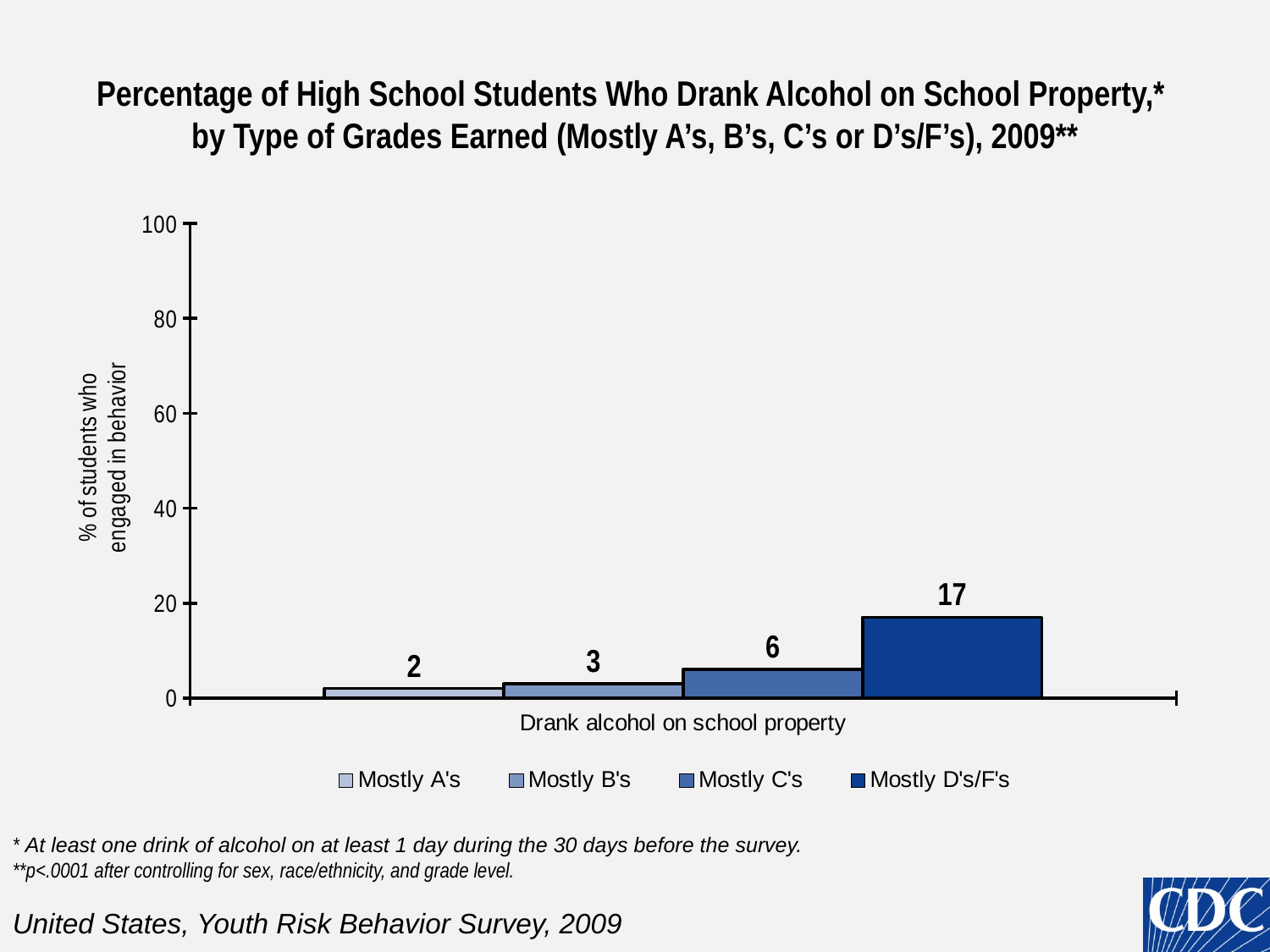
What is the difference between the values for mostly C's and mostly B's? 3 Which is larger, the value for mostly B's or the value for mostly C's? Mostly C's What percentage of students who earned mostly A's drank alcohol on school property? 2 Which grade group has the highest percentage of students who drank alcohol on school property? Mostly D's/F's What is the difference between the values for mostly D's/F's and mostly A's? 15 How many series does the legend list? 4 Which grade group has the lowest percentage of students who drank alcohol on school property? Mostly A's What is the value shown for students with mostly D's/F's? 17 What kind of chart is shown on the slide? Bar chart Is the value for mostly D's/F's greater or less than 20? less What is the value shown for students with mostly C's? 6 What is the label on the y axis of the chart? % of students who engaged in behavior